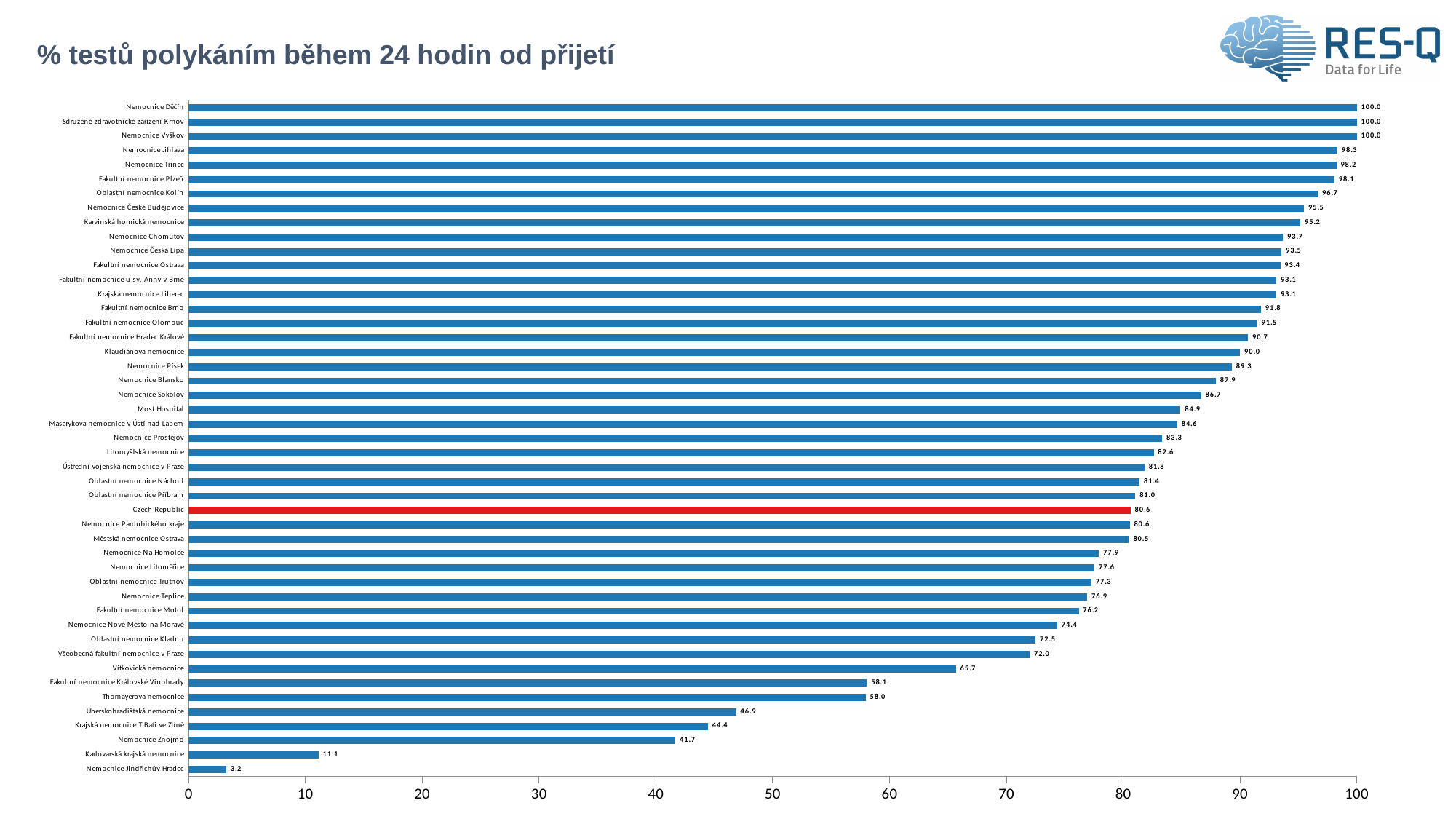
What is the value for Vítkovická nemocnice? 65.7 What is the difference between the values for Nemocnice Znojmo and Karlovarská krajská nemocnice? 30.6 Is the value for Thomayerova nemocnice greater or less than 60? less What is the value for Czech Republic? 80.6 What kind of chart is shown on the slide? bar chart Which bar is highlighted in red? Czech Republic What is the value for Fakultní nemocnice Motol? 76.2 What is the title of the chart? % testů polykáním během 24 hodin od přijetí Which is larger, the value for Nemocnice Teplice or the value for Oblastní nemocnice Kladno? Nemocnice Teplice Which category has the lowest value? Nemocnice Jindřichův Hradec How many categories are shown on the chart? 47 What is the value for Nemocnice Jindřichův Hradec? 3.2